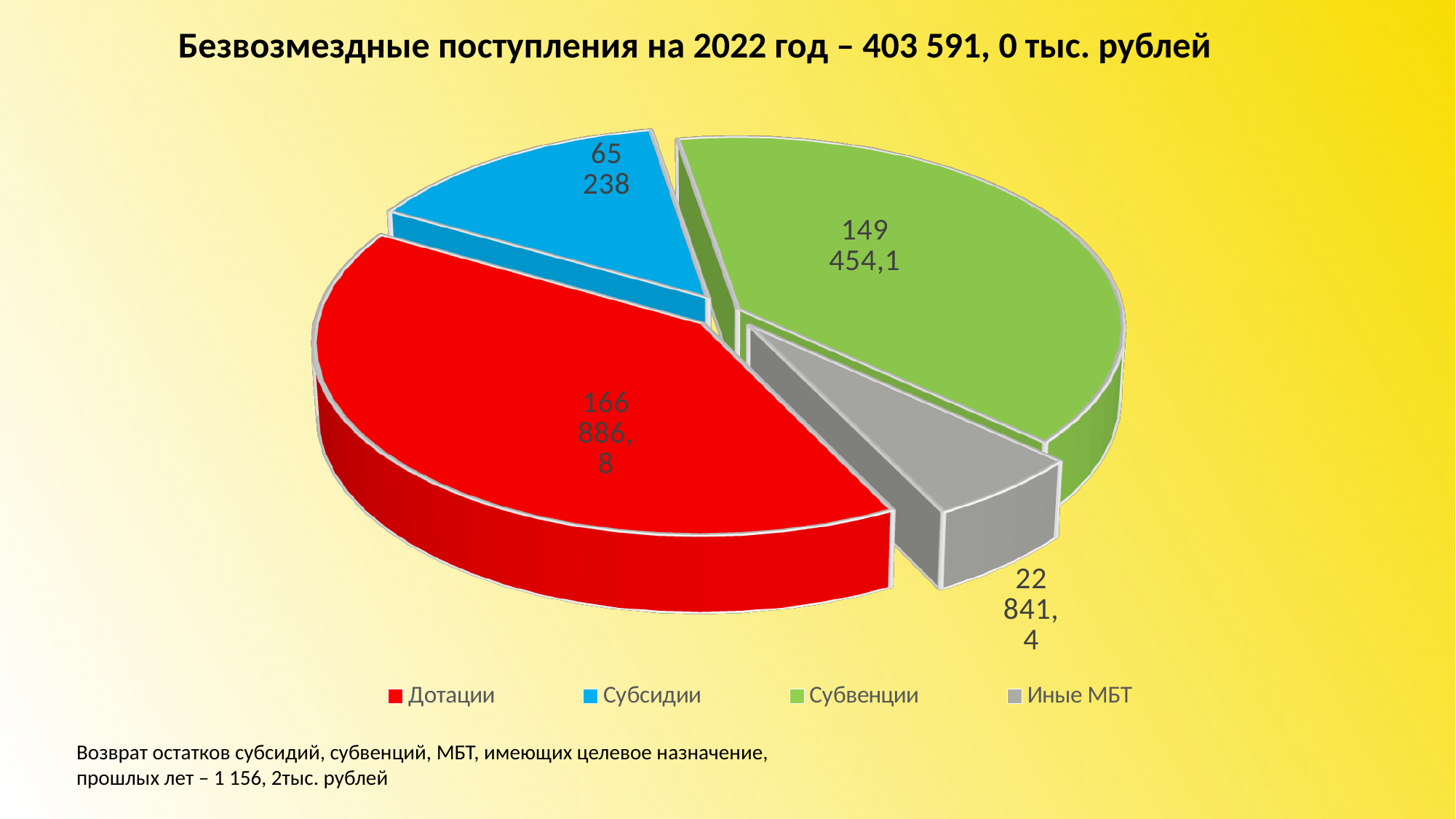
What is the value shown for Субвенции? 149 454,1 What is the difference between the values for Субсидии and Иные МБТ? 42 396,6 What colour is the Субвенции slice in the chart? Green How many slices does the pie chart have? 4 What is the value shown for Дотации? 166 886,8 Which is larger, the value for Субсидии or the value for Иные МБТ? Субсидии What is the value shown for Иные МБТ? 22 841,4 Which category has the smallest slice of the pie? Иные МБТ What is the value shown for Субсидии? 65 238 What is the difference between the values for Дотации and Субвенции? 17 432,7 Which category has the largest slice of the pie? Дотации What kind of chart is shown on the slide? Pie chart